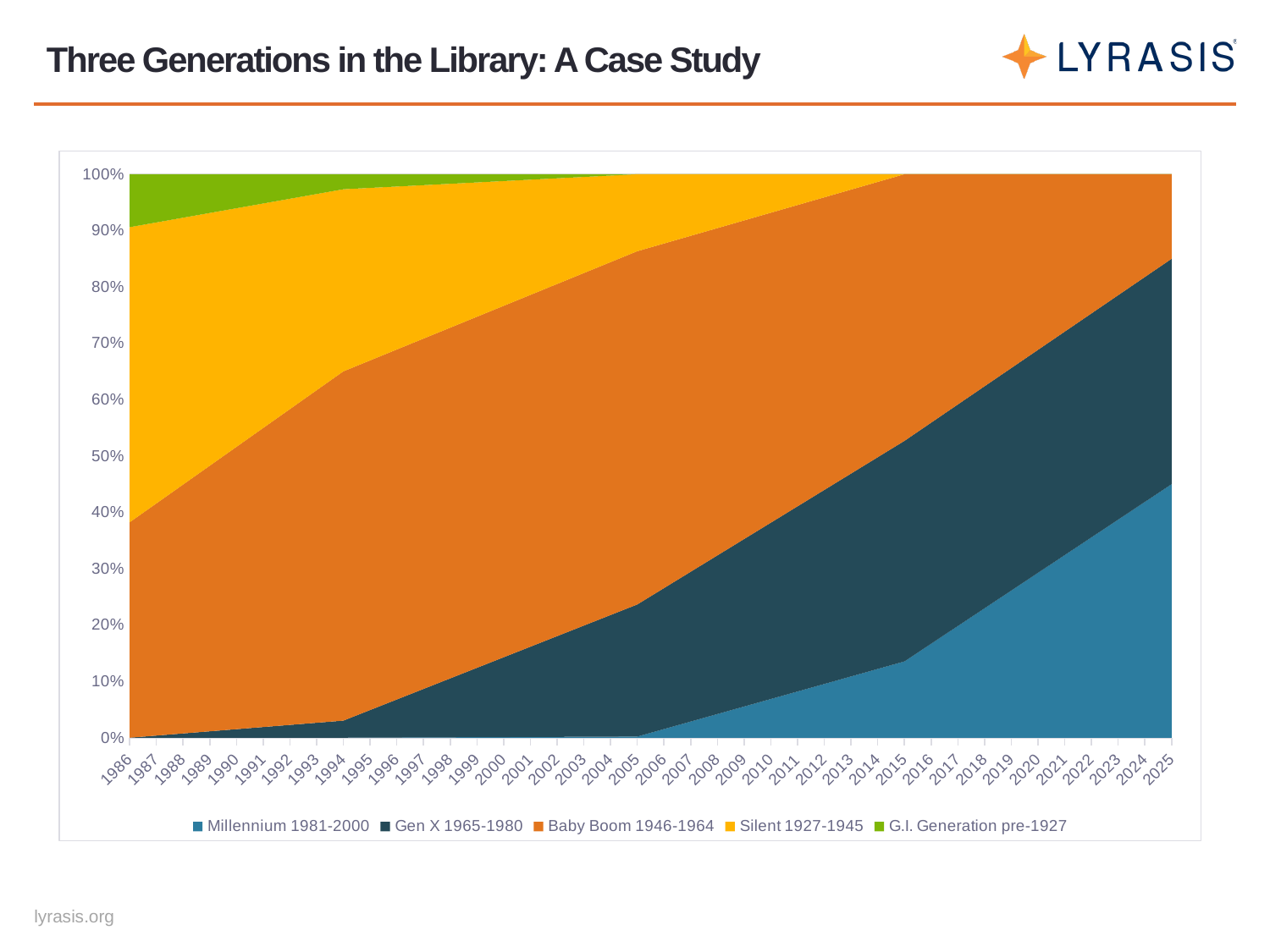
How many series does the legend list? 5 What kind of chart is shown on the slide? Stacked area chart In 2015, which is larger: the share for Gen X 1965-1980 or the share for Millennium 1981-2000? Gen X 1965-1980 Is the share for Baby Boom 1946-1964 in 2025 greater or less than 20%? less Is the share for Millennium 1981-2000 in 2025 greater or less than 40%? greater Which generation has the largest share in 2005? Baby Boom 1946-1964 Does the share for Millennium 1981-2000 rise or fall from 1986 to 2025? Rise What is the last year shown on the x axis? 2025 What is the first year shown on the x axis? 1986 How many years are shown along the x axis? 40 Does the share for Silent 1927-1945 rise or fall from 1986 to 2025? Fall